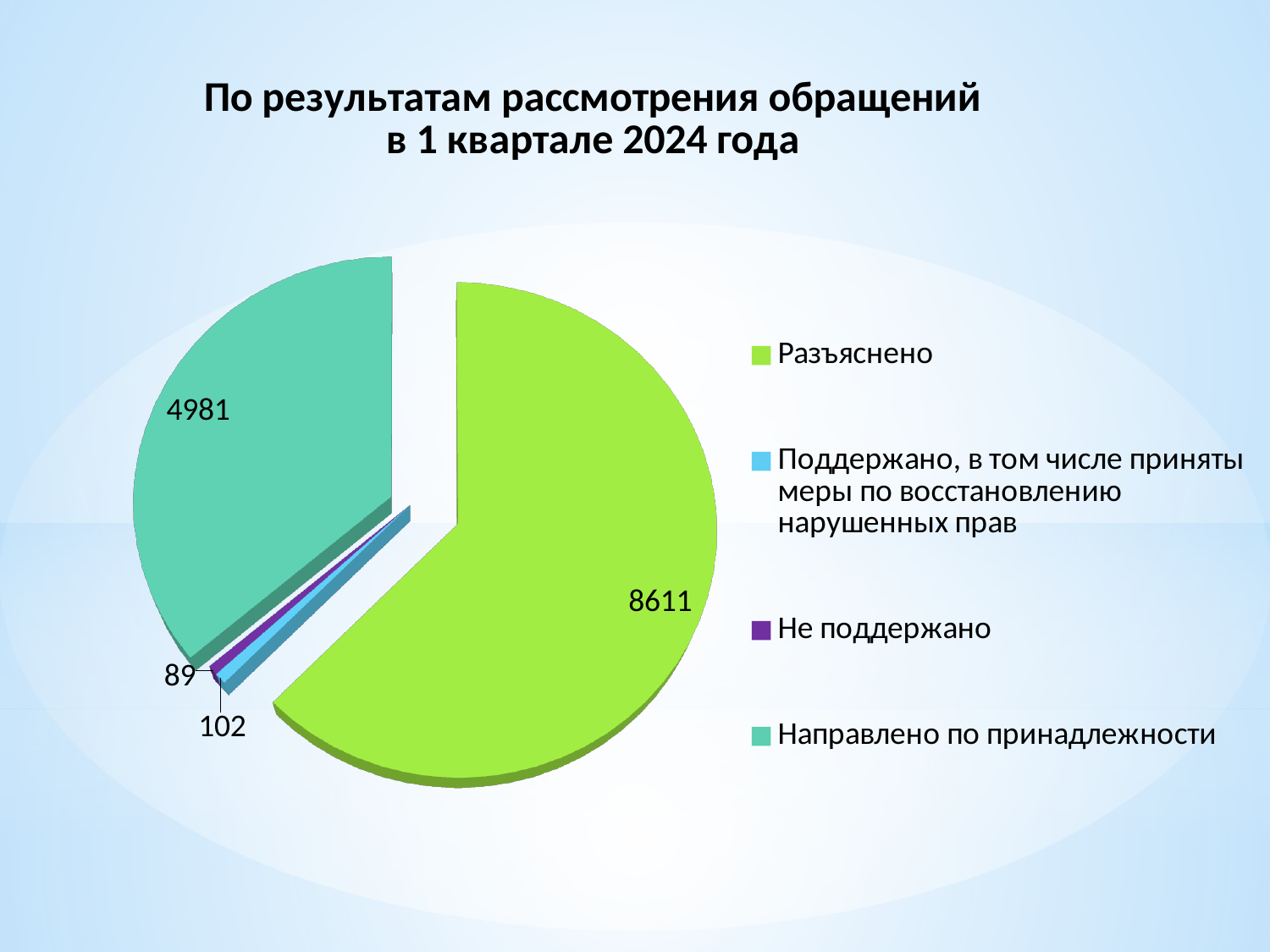
What kind of chart is shown on the slide? pie chart Which is larger, the value for Разъяснено or the value for Направлено по принадлежности? Разъяснено What is the value for Поддержано, в том числе приняты меры по восстановлению нарушенных прав? 102 What is the difference between the values for Поддержано and Не поддержано? 13 Which category has the smallest slice of the pie? Не поддержано Which category has the largest slice of the pie? Разъяснено What is the value for Направлено по принадлежности? 4981 How many categories does the legend list? 4 What is the value for Не поддержано? 89 What is the difference between the values for Разъяснено and Направлено по принадлежности? 3630 What is the value for Разъяснено? 8611 What colour is the slice for Направлено по принадлежности? teal